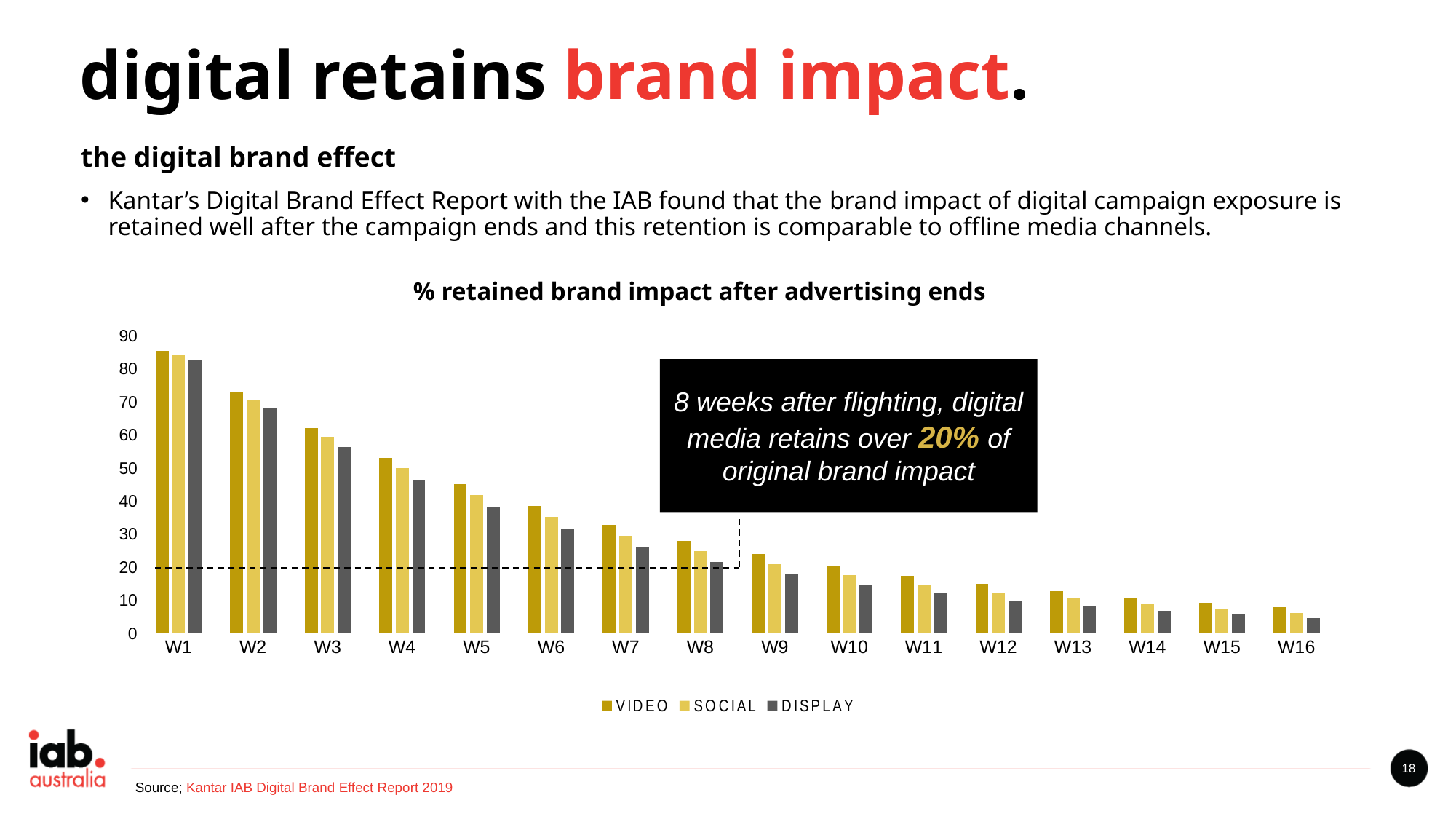
How many series does the chart legend list? 3 Is the VIDEO value for W1 greater or less than 80? greater Do the VIDEO values rise or fall from W1 to W16? fall Is the VIDEO value for W5 greater or less than 40? greater How many weeks (categories) are shown on the x axis of the chart? 16 What kind of chart is shown on the slide? bar chart What is the title of the chart? % retained brand impact after advertising ends Is the VIDEO value for W16 greater or less than 10? less In which week is the VIDEO value highest? W1 At W3, which is larger, the VIDEO value or the DISPLAY value? VIDEO In which week is the DISPLAY value lowest? W16